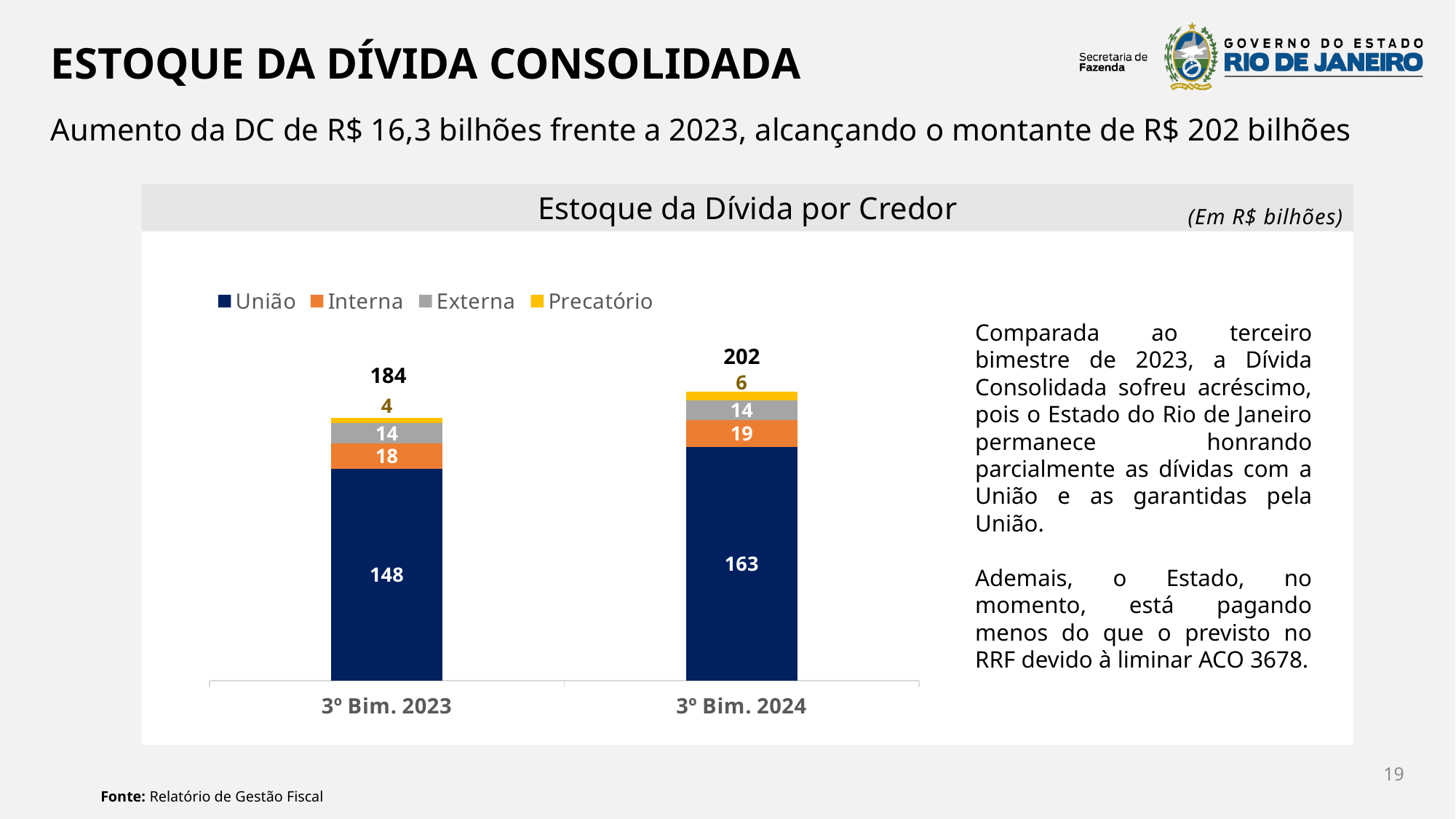
What is the value of União for 3º Bim. 2024? 163 What is the value of Interna for 3º Bim. 2023? 18 Which period has the higher total debt stock? 3º Bim. 2024 Which series has the smallest value in the 3º Bim. 2024 bar? Precatório How many series does the legend list? 4 What kind of chart is shown? Stacked bar chart What is the value of Precatório for 3º Bim. 2024? 6 What is the total of the stacked bar for 3º Bim. 2023? 184 What is the title of the chart? Estoque da Dívida por Credor What is the difference between the União values for 3º Bim. 2024 and 3º Bim. 2023? 15 What is the total of the stacked bar for 3º Bim. 2024? 202 Which series has the largest value in the 3º Bim. 2023 bar? União